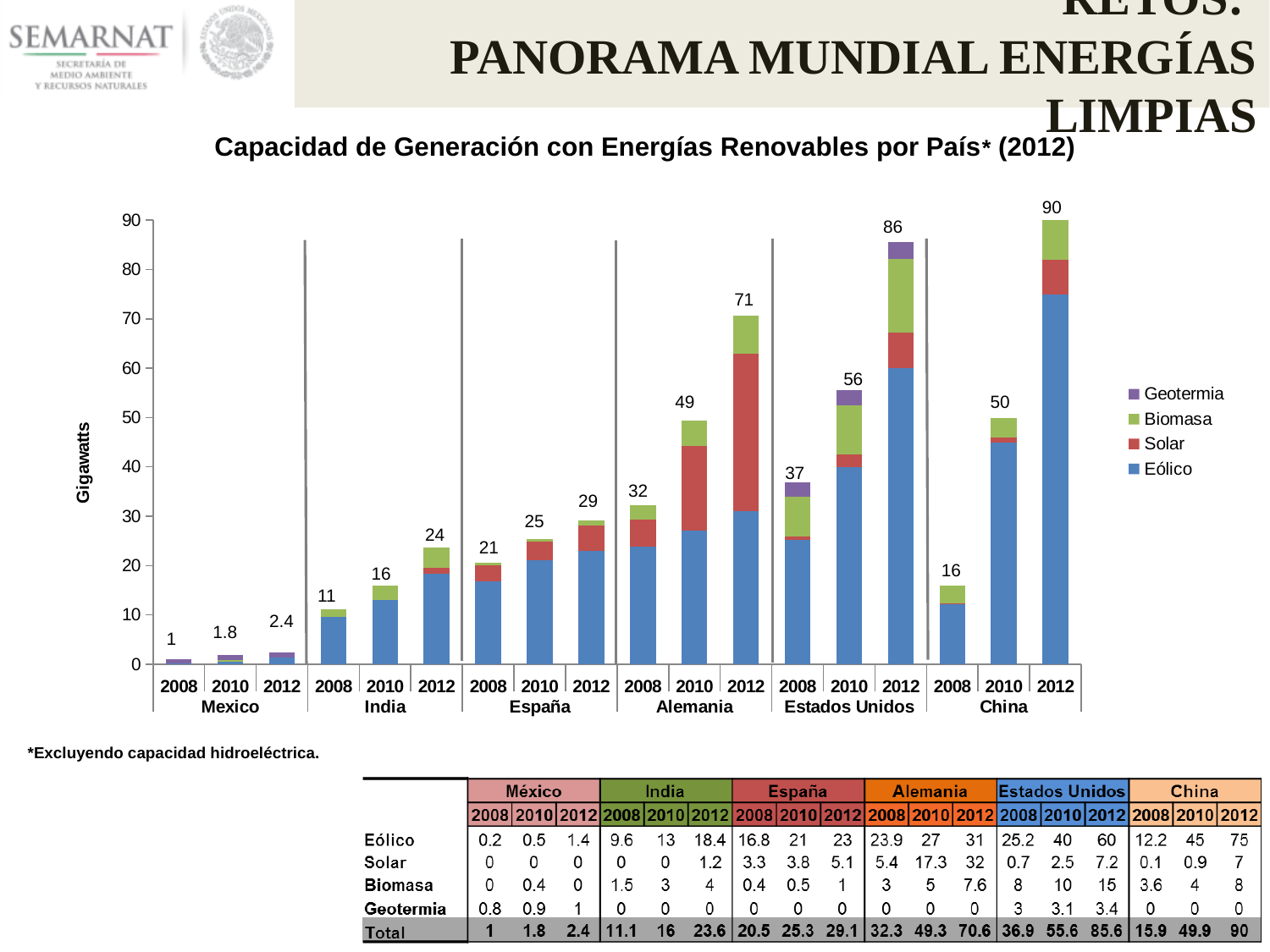
Which country-year bar has the lowest total in the chart? Mexico 2008 How many bars are plotted in the chart? 18 According to the table, what is the Eólico value for China in 2012? 75 What is the total labeled on the bar for Alemania in 2010? 49 What is the total labeled on the bar for China in 2012? 90 What is the difference between the labeled totals for Estados Unidos in 2012 and 2008? 49 What type of chart is shown on the slide? Stacked bar chart Which country-year bar has the highest total in the chart? China 2012 Do the labeled totals for Alemania rise or fall from 2008 to 2012? Rise What unit is shown on the y-axis of the chart? Gigawatts How many series does the chart legend list? 4 Which is larger, the labeled total for India in 2012 or for España in 2012? España 2012